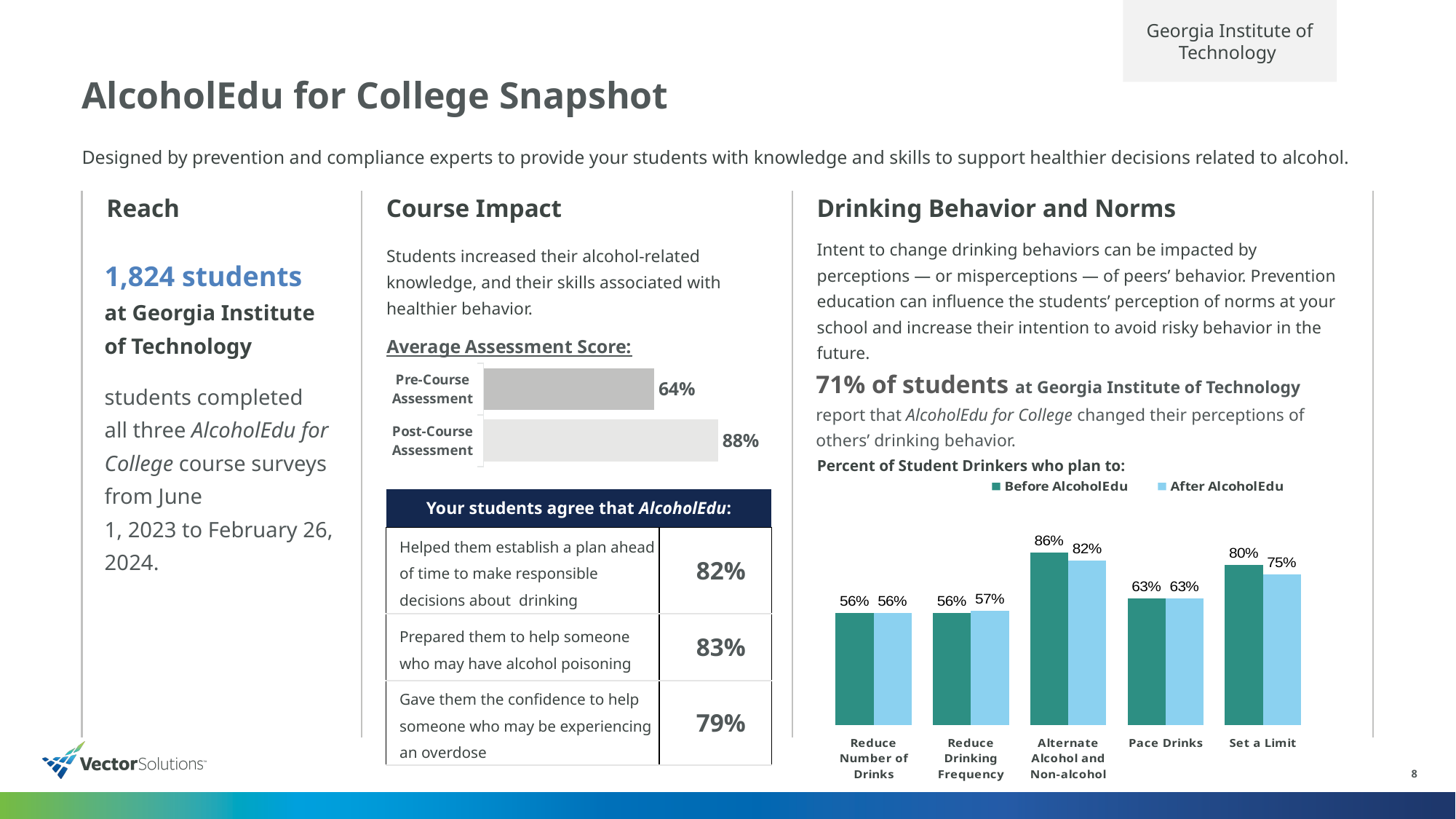
In the Percent of Student Drinkers who plan to chart, what is the difference between the Before and After AlcoholEdu values for Set a Limit? 5% In the Percent of Student Drinkers who plan to chart, is the Before AlcoholEdu value for Pace Drinks larger or smaller than the Before AlcoholEdu value for Alternate Alcohol and Non-alcohol? Smaller In the Percent of Student Drinkers who plan to chart, what is the Before AlcoholEdu value for Set a Limit? 80% How many series does the legend of the Percent of Student Drinkers who plan to chart list? 2 In the Average Assessment Score chart, what is the Post-Course Assessment value? 88% In the Percent of Student Drinkers who plan to chart, which category has the highest Before AlcoholEdu value? Alternate Alcohol and Non-alcohol In the Average Assessment Score chart, what is the difference between the Post-Course and Pre-Course Assessment values? 24% In the Percent of Student Drinkers who plan to chart, what is the After AlcoholEdu value for Reduce Drinking Frequency? 57% What kind of chart is the Average Assessment Score chart? Bar chart In the Average Assessment Score chart, what is the Pre-Course Assessment value? 64% In the Percent of Student Drinkers who plan to chart, which category has the lowest After AlcoholEdu value? Reduce Number of Drinks How many categories are shown in the Percent of Student Drinkers who plan to chart? 5